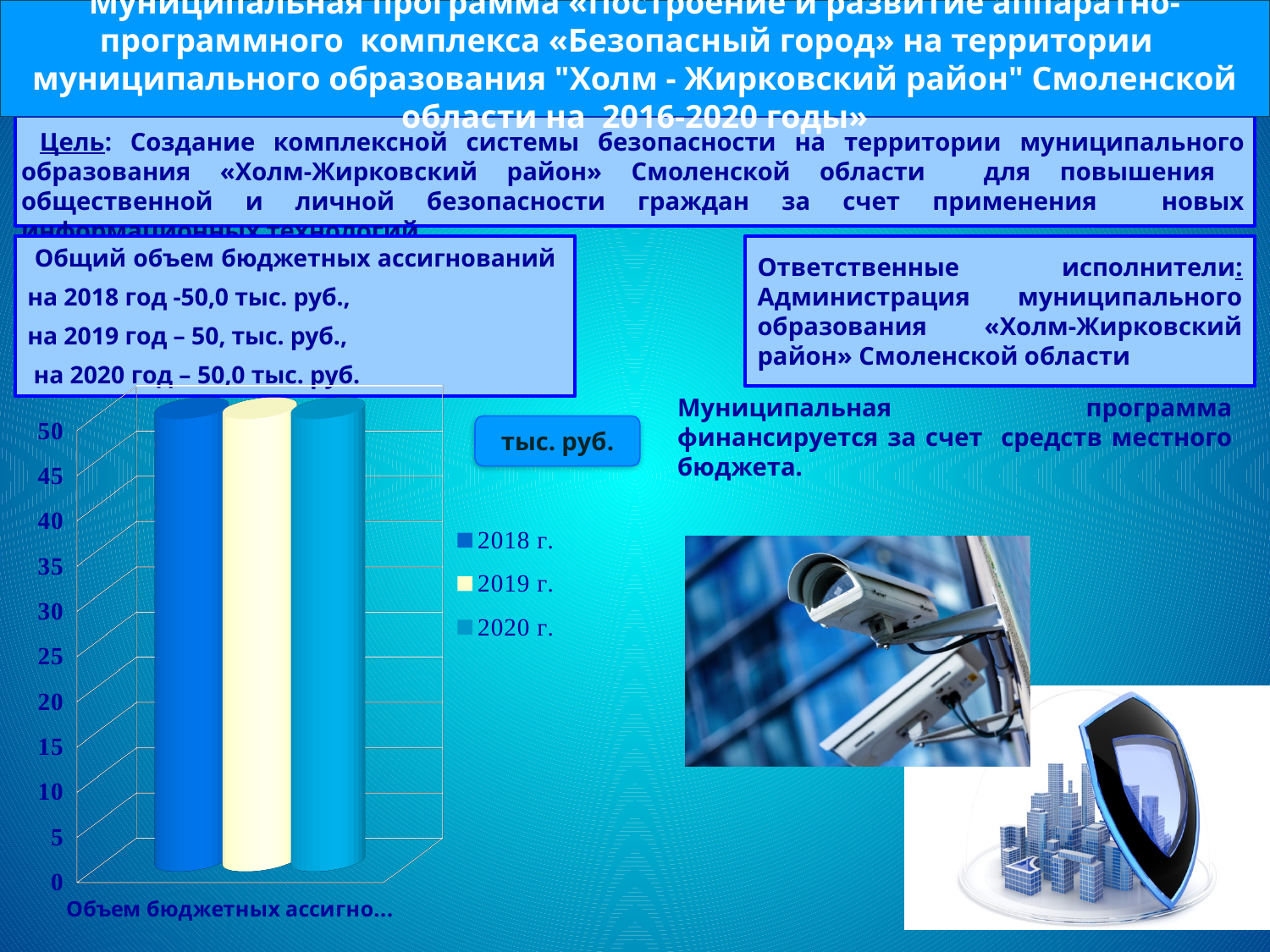
What unit is shown in the label box next to the chart? тыс. руб. What kind of chart is shown on the slide? bar chart What is the value of the bar for 2018 г.? 50 What is the value of the bar for 2019 г.? 50 Is the value for 2019 г. greater or less than 45? greater Which years are listed in the chart legend? 2018 г., 2019 г., 2020 г. Do the bar values rise, fall, or stay the same from 2018 г. to 2020 г.? stay the same How many categories are shown on the x axis of the chart? 1 What is the highest value shown on the chart's vertical axis? 50 What is the value of the bar for 2020 г.? 50 How many series does the chart legend list? 3 Is the value for 2020 г. greater or less than 40? greater